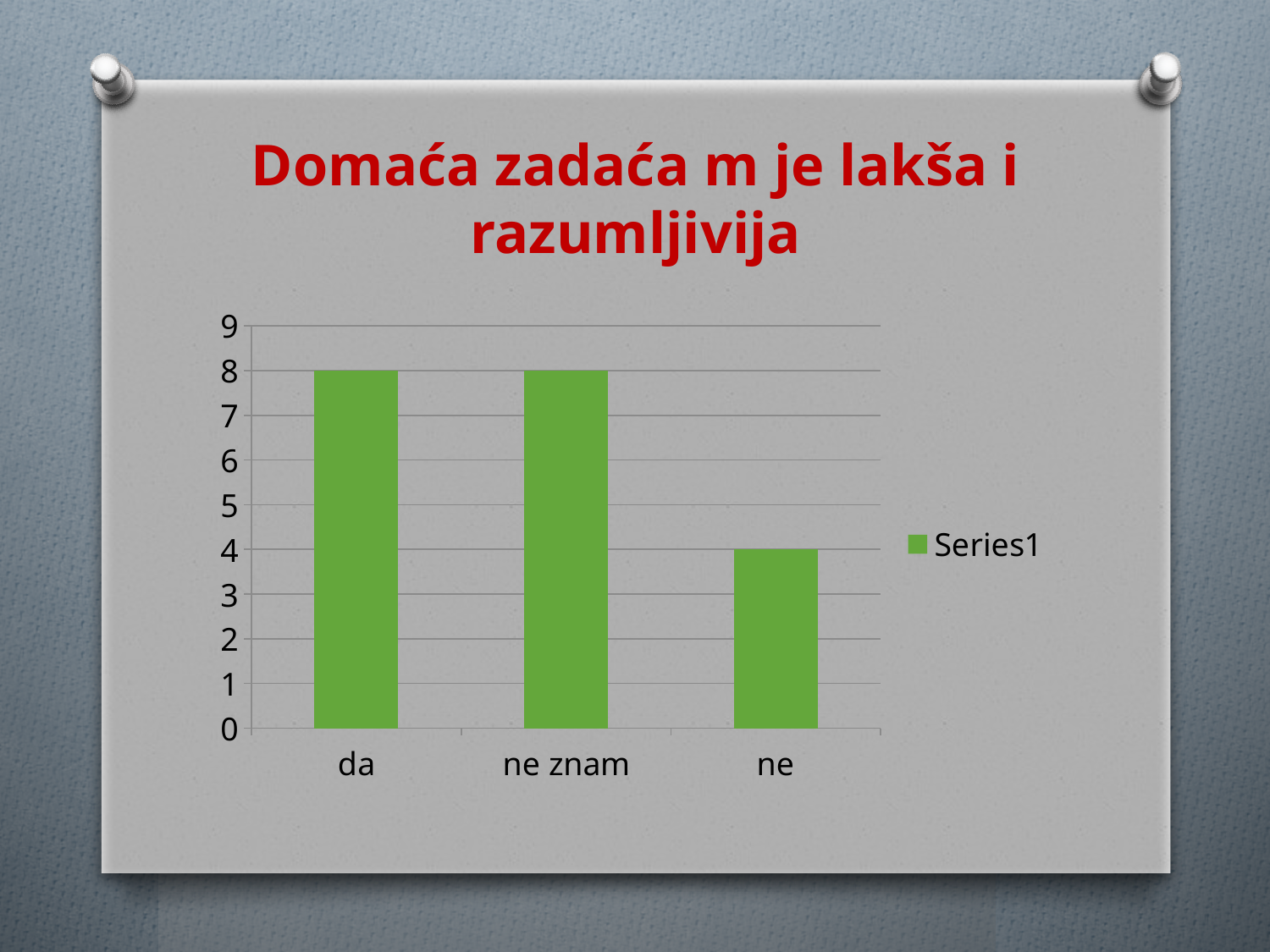
Is the value for "ne" greater or less than 5? less What is the value for "ne"? 4 What kind of chart is shown on the slide? bar chart How many series does the legend list? 1 Which is larger, the value for "ne znam" or the value for "ne"? ne znam What is the value for "ne znam"? 8 What is the title of the slide above the chart? Domaća zadaća m je lakša i razumljivija How many categories are shown on the x axis? 3 What is the value for "da"? 8 What is the difference between the values for "da" and "ne"? 4 Is the value for "da" greater or less than 6? greater Which category has the lowest value? ne